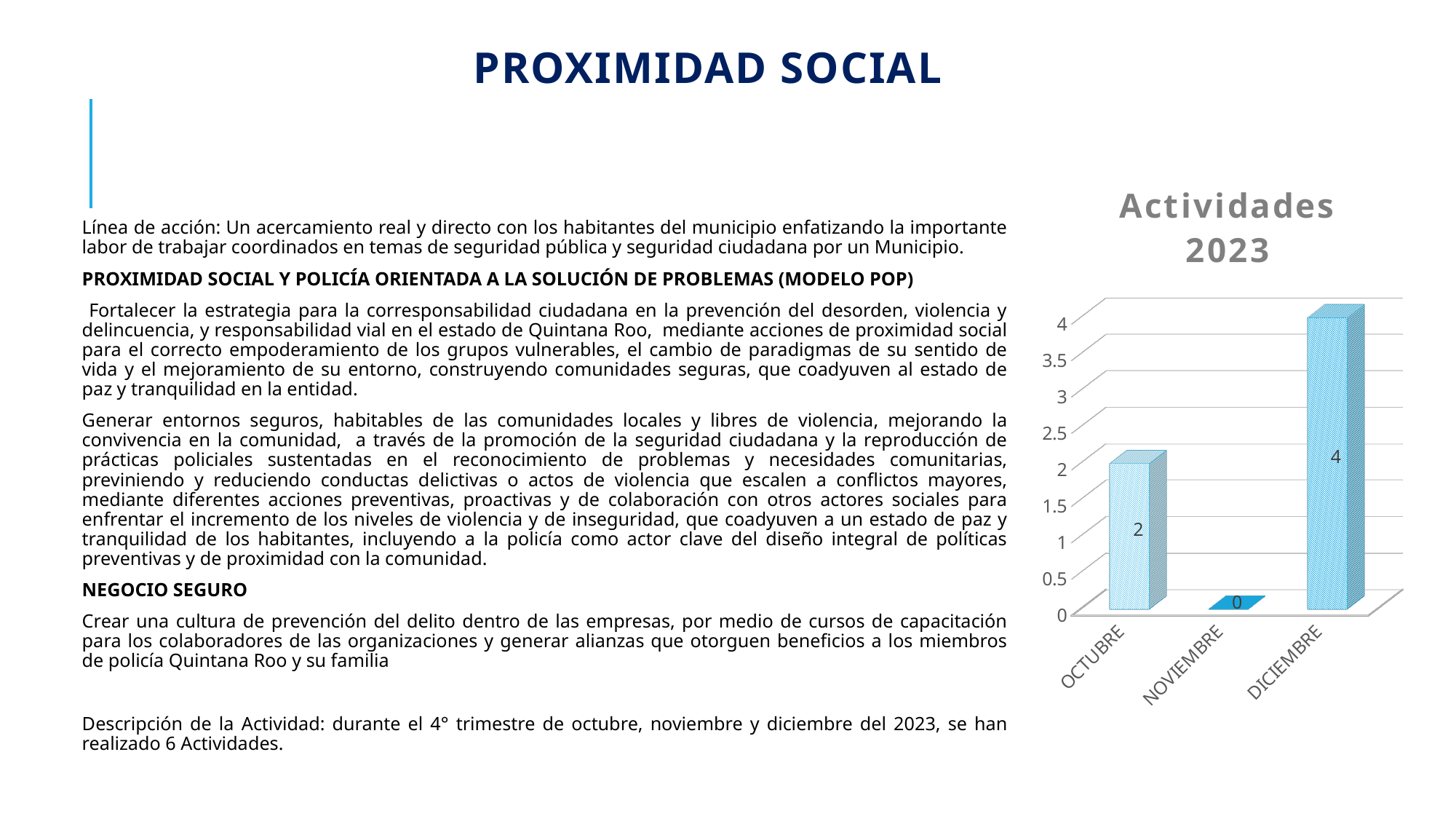
What kind of chart is the Actividades 2023 chart? bar chart Is the value for DICIEMBRE in the Actividades 2023 chart greater or less than 3? greater How many months are shown on the x axis of the Actividades 2023 chart? 3 What is the value for OCTUBRE in the Actividades 2023 chart? 2 What is the difference between the values for DICIEMBRE and OCTUBRE in the Actividades 2023 chart? 2 What is the total of the values for OCTUBRE, NOVIEMBRE and DICIEMBRE in the Actividades 2023 chart? 6 What is the title of the chart on the slide? Actividades 2023 Which month has the lowest value in the Actividades 2023 chart? NOVIEMBRE What is the value for NOVIEMBRE in the Actividades 2023 chart? 0 Which month has the highest value in the Actividades 2023 chart? DICIEMBRE Which is larger in the Actividades 2023 chart, the value for OCTUBRE or the value for DICIEMBRE? DICIEMBRE What is the value for DICIEMBRE in the Actividades 2023 chart? 4